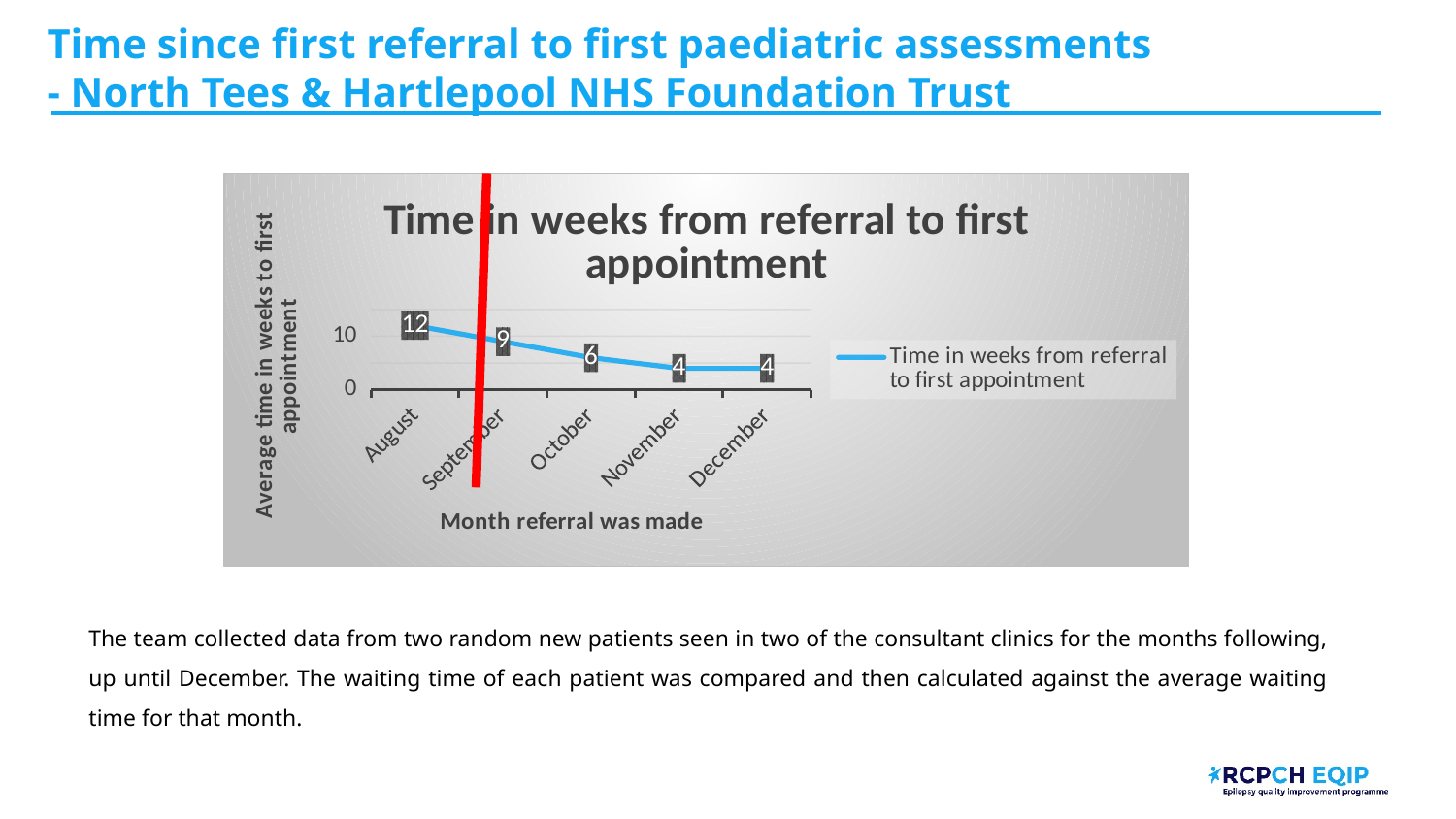
What is the value for October in the chart? 6 What is the difference between the values for September and November? 5 What is the value for December in the chart? 4 What is the difference between the values for August and September? 3 Do the values rise or fall from August to December? fall Which month has the highest value in the chart? August Is the value for August greater or less than 10? greater What is the value for August in the chart? 12 Which is larger, the value for September or the value for October? September How many months are plotted on the x axis of the chart? 5 What kind of chart is shown on the slide? line chart How many series does the legend list? 1